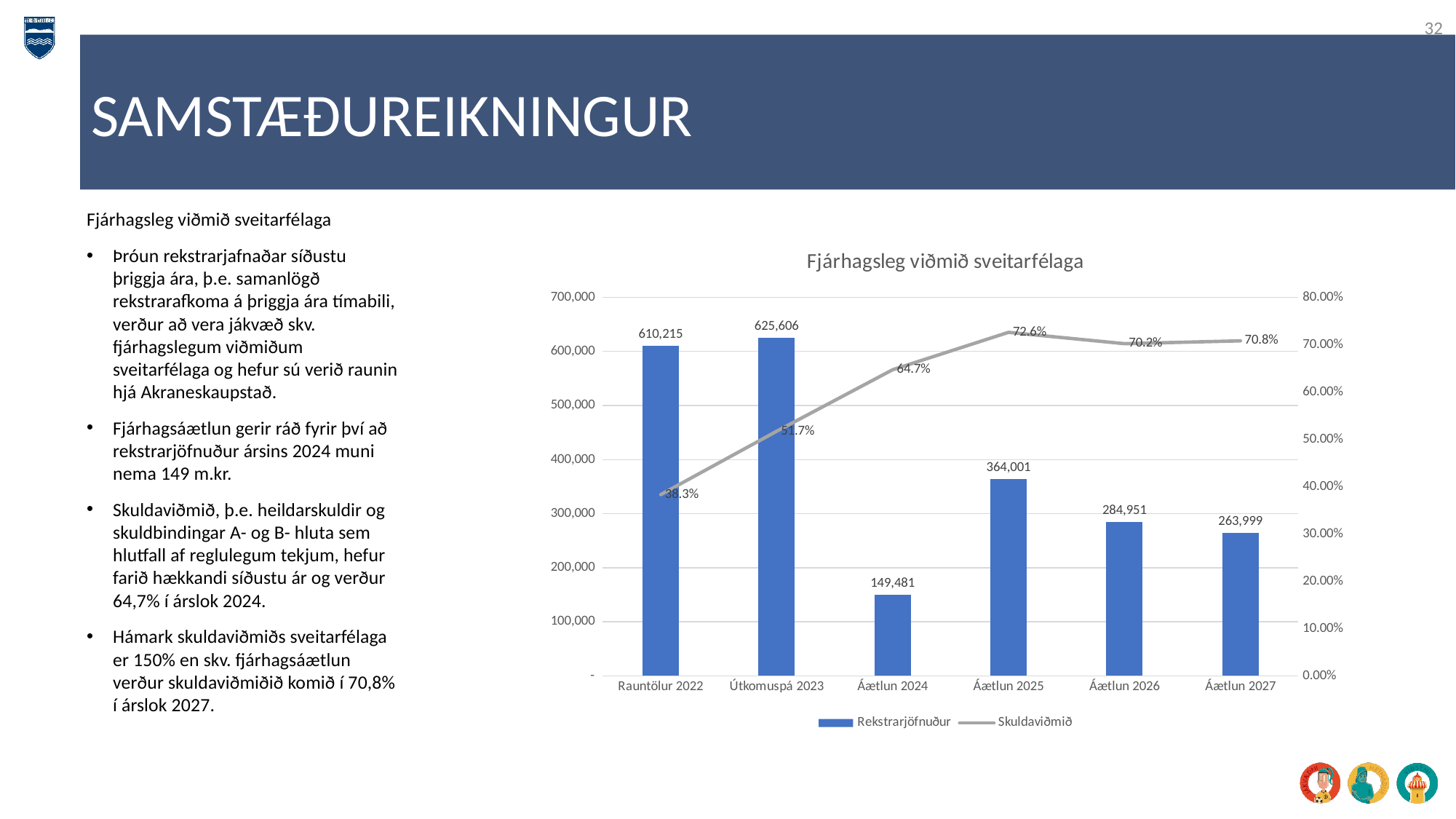
Which category has the highest Skuldaviðmið value? Áætlun 2025 Which is larger, the Rekstrarjöfnuður value for Rauntölur 2022 or for Útkomuspá 2023? Útkomuspá 2023 How many categories are shown on the x axis? 6 Does the Skuldaviðmið series rise or fall from Rauntölur 2022 to Áætlun 2025? rise What is the Rekstrarjöfnuður value for Áætlun 2027? 263,999 What is the title of the chart? Fjárhagsleg viðmið sveitarfélaga Which category has the lowest Rekstrarjöfnuður value? Áætlun 2024 How many series does the legend list? 2 Which category has the highest Rekstrarjöfnuður value? Útkomuspá 2023 What is the Rekstrarjöfnuður value for Útkomuspá 2023? 625,606 What is the Skuldaviðmið value for Áætlun 2024? 64.7% What is the difference between the Rekstrarjöfnuður values for Áætlun 2025 and Áætlun 2026? 79,050